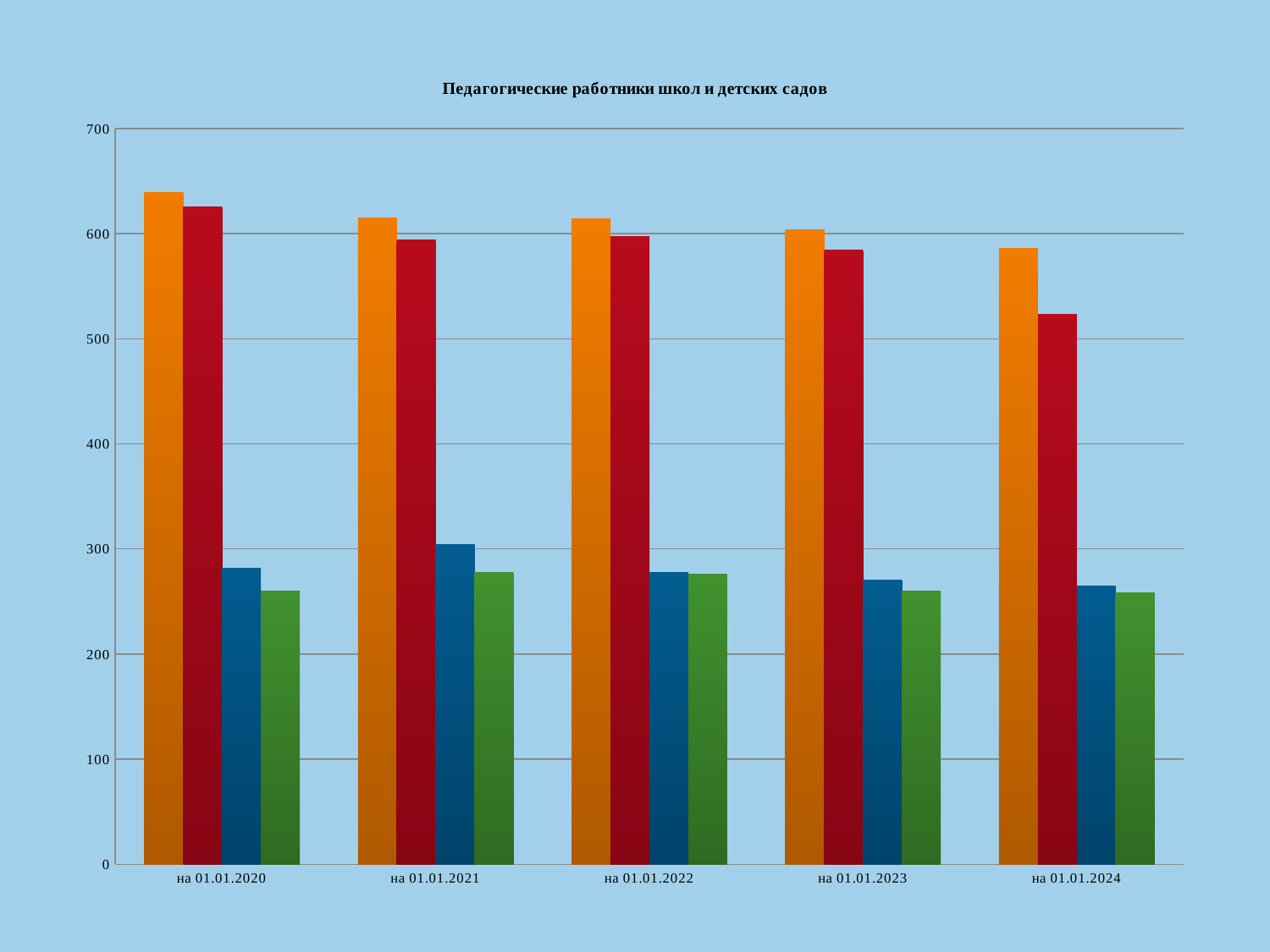
Is the value of the red bar for на 01.01.2024 greater or less than 600? less For на 01.01.2024, which is larger: the orange bar or the red bar? the orange bar Is the value of the blue bar for на 01.01.2024 greater or less than 300? less For which date is the orange bar the highest? на 01.01.2020 Is the value of the orange bar for на 01.01.2020 greater or less than 600? greater How many bars are plotted for each date category? 4 For which date is the red bar the lowest? на 01.01.2024 What kind of chart is shown on the slide? bar chart Do the orange bars rise or fall from на 01.01.2020 to на 01.01.2024? fall What is the title of the chart? Педагогические работники школ и детских садов How many date categories are shown on the x axis? 5